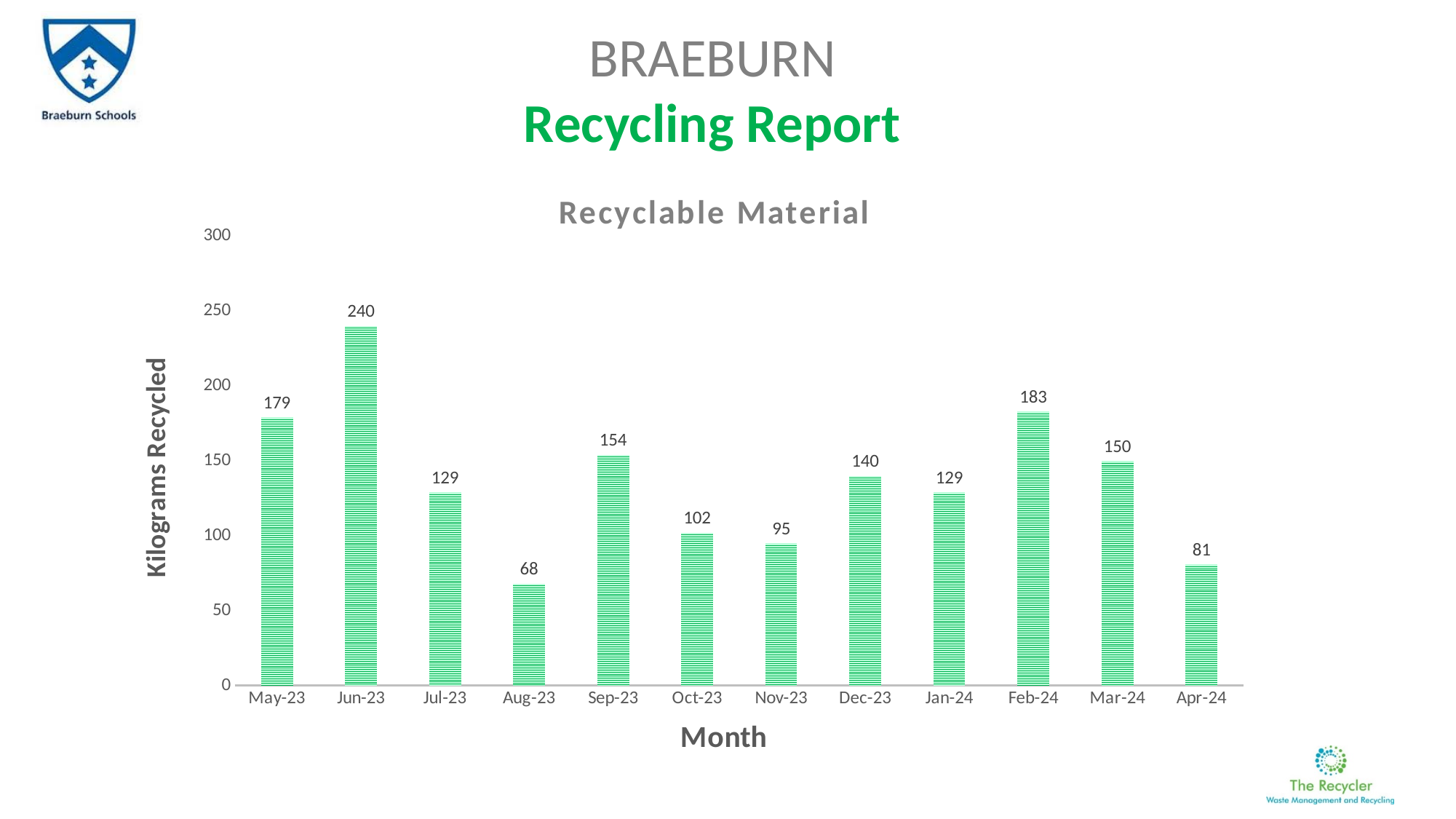
Is the value for Nov-23 greater or less than 100? less What is the difference between the values for Jun-23 and May-23? 61 How many kilograms were recycled in Aug-23? 68 What is the title of the chart? Recyclable Material What is the value for Feb-24? 183 Which month has the lowest value in the chart? Aug-23 Which month has the highest value in the chart? Jun-23 What is the difference between the values for Mar-24 and Apr-24? 69 What kind of chart is shown on the slide? bar chart How many months are shown on the x axis of the chart? 12 What is the value for Jun-23 in the Recyclable Material chart? 240 Which is larger, the value for Sep-23 or the value for Dec-23? Sep-23